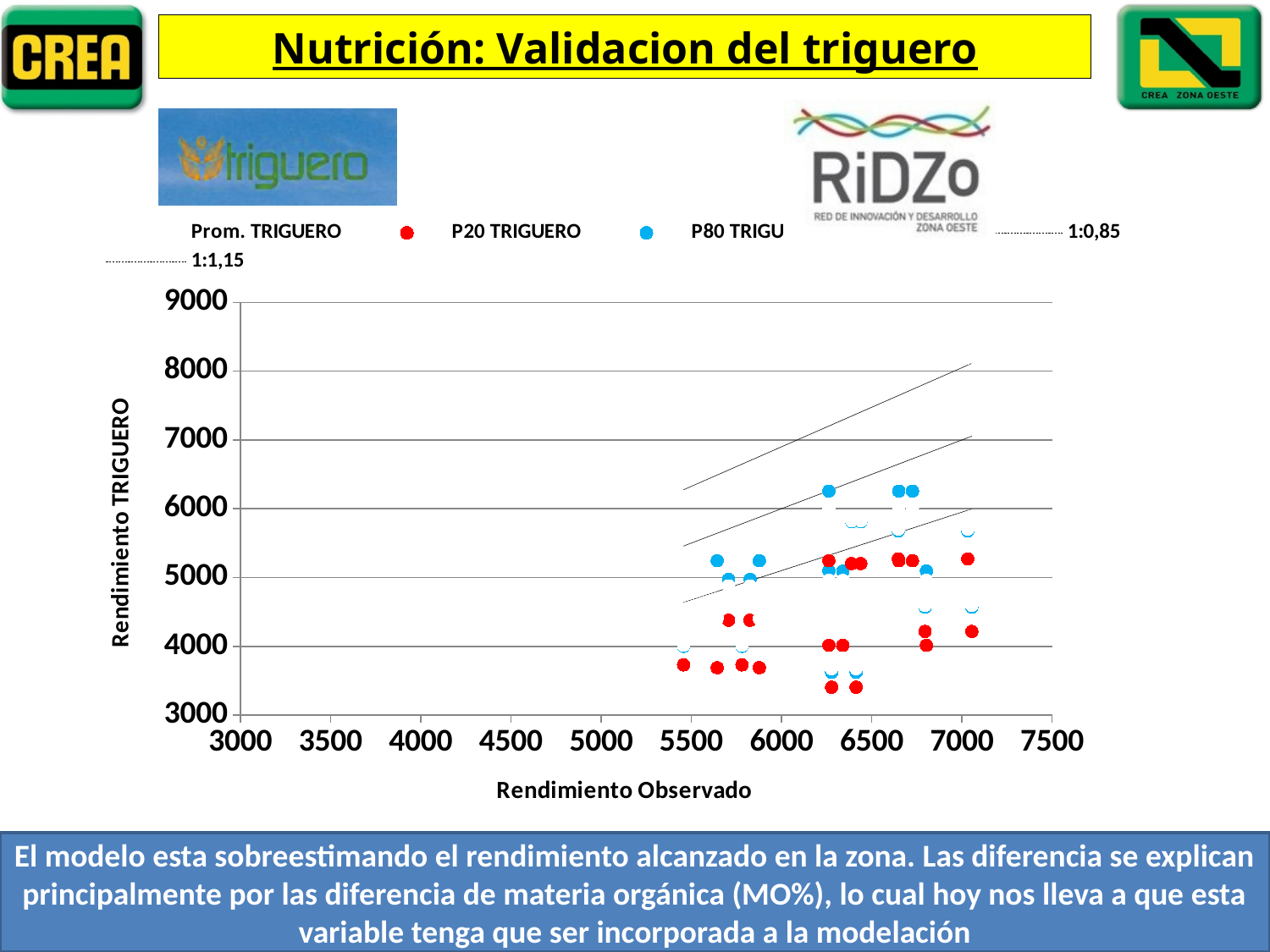
Which series has the higher plotted points on the chart, P80 TRIGUERO or P20 TRIGUERO? P80 TRIGUERO Is the highest P80 TRIGUERO point on the chart greater or less than 6000 on the vertical axis? greater Are the plotted points on the chart located at observed yields greater or less than 5000 on the horizontal axis? greater What is the title of the horizontal axis of the chart? Rendimiento Observado How many entries does the chart legend list? 5 Is the lowest P20 TRIGUERO point on the chart greater or less than 4000 on the vertical axis? less What kind of chart is shown on the slide? scatter chart What is the title of the vertical axis of the chart? Rendimiento TRIGUERO